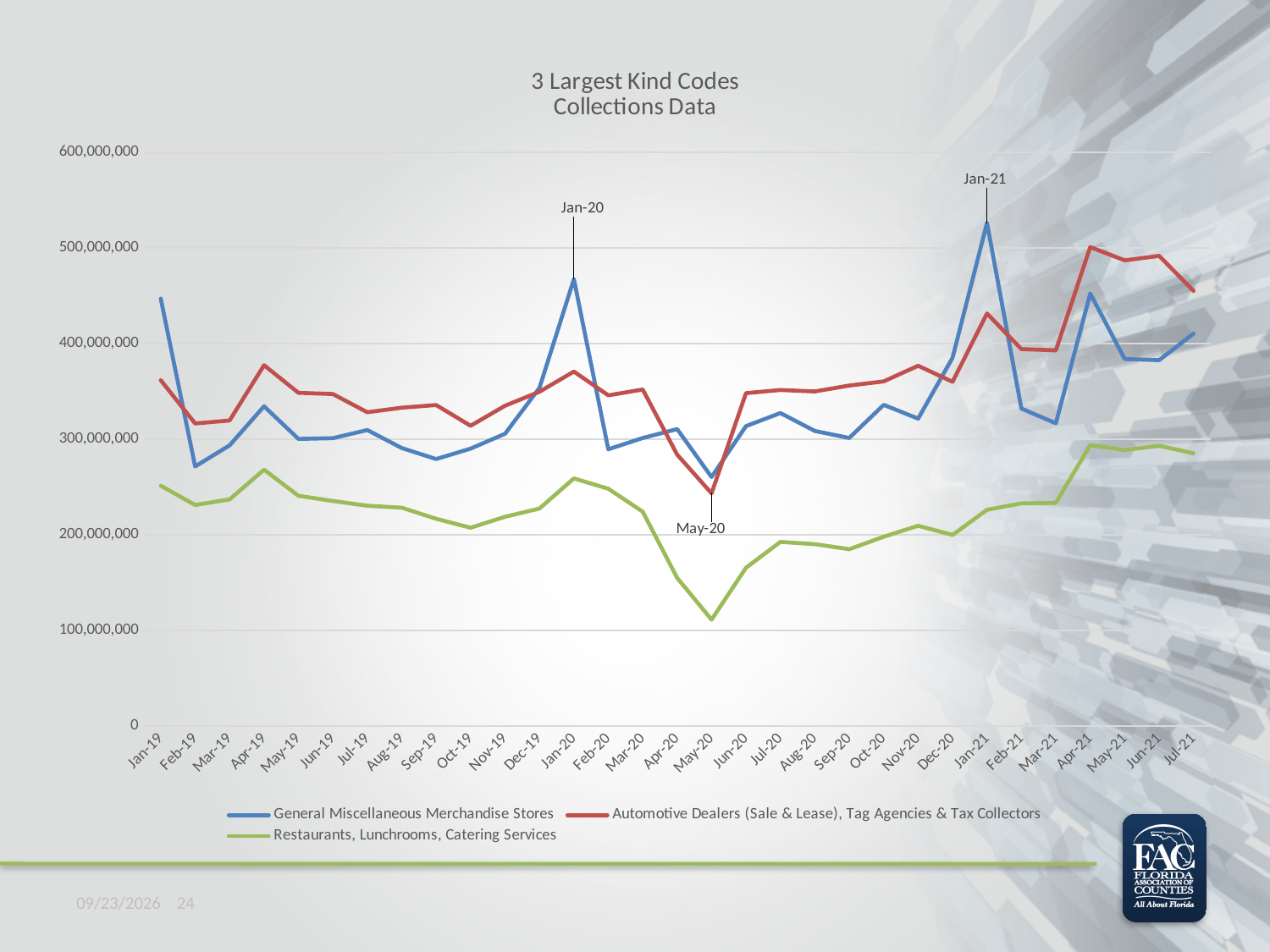
How many series does the legend list? 3 Is the value for Restaurants, Lunchrooms, Catering Services in May-20 greater or less than 200,000,000? less Which three months are called out with annotation labels on the chart? Jan-20, May-20, Jan-21 What kind of chart is shown on the slide? Line chart In which month does the General Miscellaneous Merchandise Stores series reach its highest value? Jan-21 How many months are plotted along the x axis? 31 Is the value for General Miscellaneous Merchandise Stores in Jan-21 greater or less than 500,000,000? greater In which month does the Restaurants, Lunchrooms, Catering Services series reach its lowest value? May-20 Is the value for Automotive Dealers (Sale & Lease), Tag Agencies & Tax Collectors in May-20 greater or less than 300,000,000? less What is the title of the chart? 3 Largest Kind Codes Collections Data In Jul-21, which series has the larger value: General Miscellaneous Merchandise Stores or Automotive Dealers (Sale & Lease), Tag Agencies & Tax Collectors? Automotive Dealers (Sale & Lease), Tag Agencies & Tax Collectors Which series has the lowest values across the entire period shown? Restaurants, Lunchrooms, Catering Services